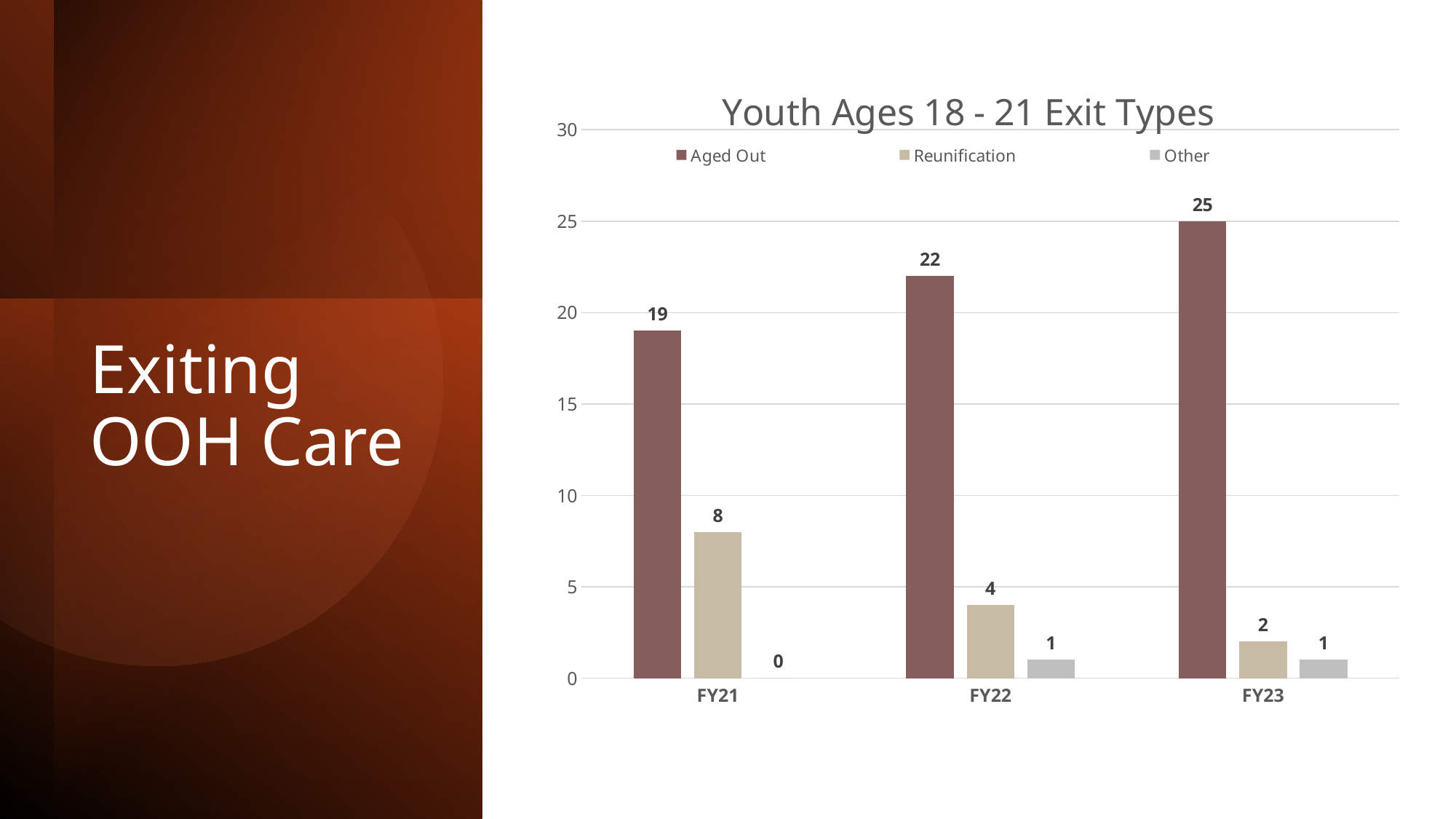
What is the difference between the Aged Out values for FY23 and FY21? 6 How many fiscal years are shown on the x axis? 3 Which is larger, the Reunification value for FY21 or for FY22? FY21 Which fiscal year has the lowest Reunification value? FY23 What is the Other value for FY23? 1 What is the Aged Out value for FY22? 22 What kind of chart is shown on the slide? Bar chart What is the Reunification value for FY21? 8 What is the title of the chart? Youth Ages 18 - 21 Exit Types How many series does the legend list? 3 Which fiscal year has the highest Aged Out value? FY23 Do the Aged Out values rise or fall from FY21 to FY23? Rise